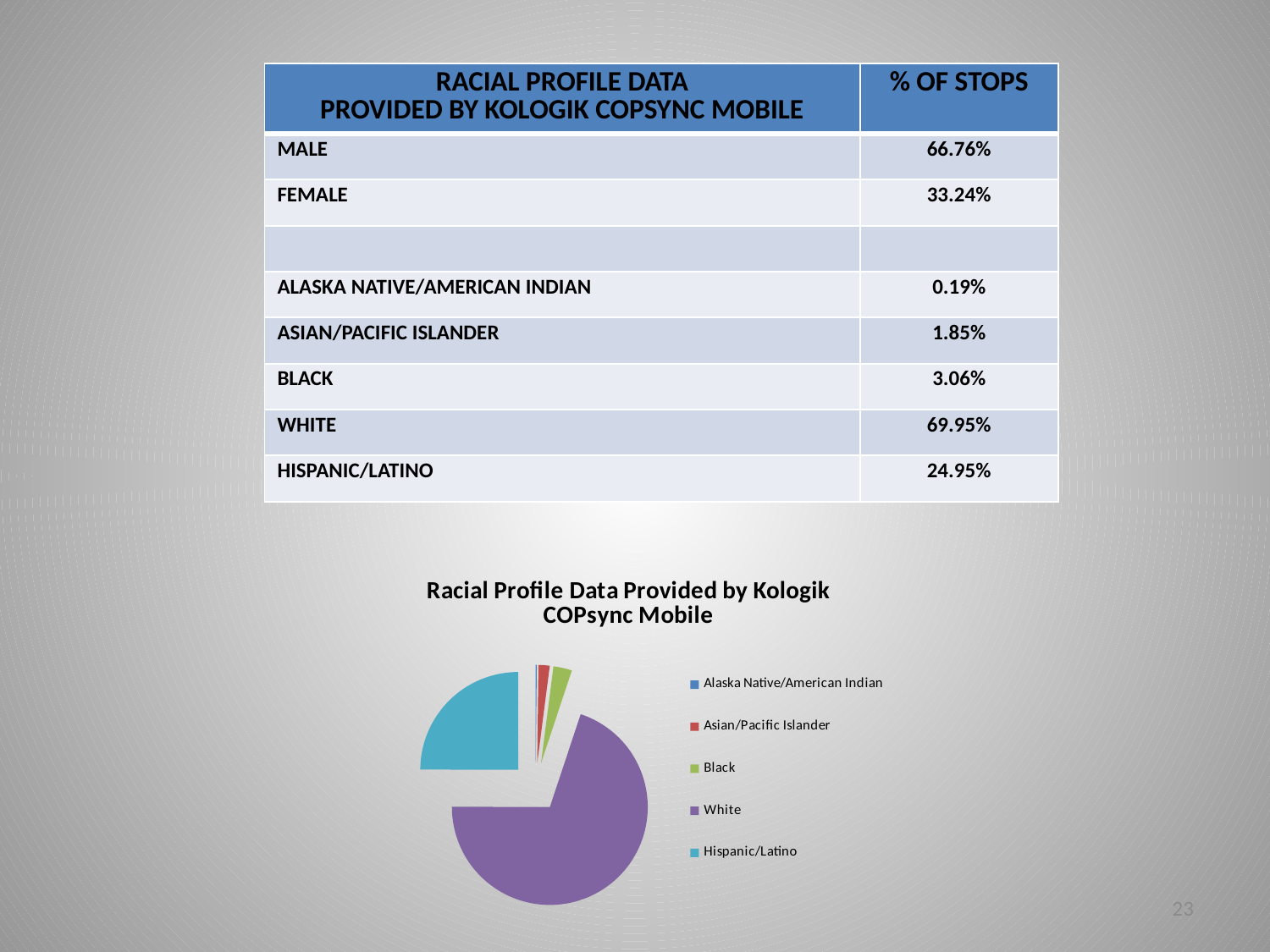
What is the title of the pie chart? Racial Profile Data Provided by Kologik COPsync Mobile According to the table, what percentage of stops does the White slice of the pie chart represent? 69.95% Which category has the smallest slice in the pie chart? Alaska Native/American Indian What kind of chart is shown on the slide? pie chart What colour is the White slice in the pie chart? purple Which slice is larger in the pie chart, Black or Asian/Pacific Islander? Black According to the table, what percentage of stops does the Hispanic/Latino slice of the pie chart represent? 24.95% Which category has the largest slice in the pie chart? White Using the table values, what is the difference between the White and Hispanic/Latino shares shown in the pie chart? 45.00% Which slice is larger in the pie chart, Hispanic/Latino or Black? Hispanic/Latino How many categories does the pie chart's legend list? 5 According to the table, what percentage of stops does the Black slice of the pie chart represent? 3.06%